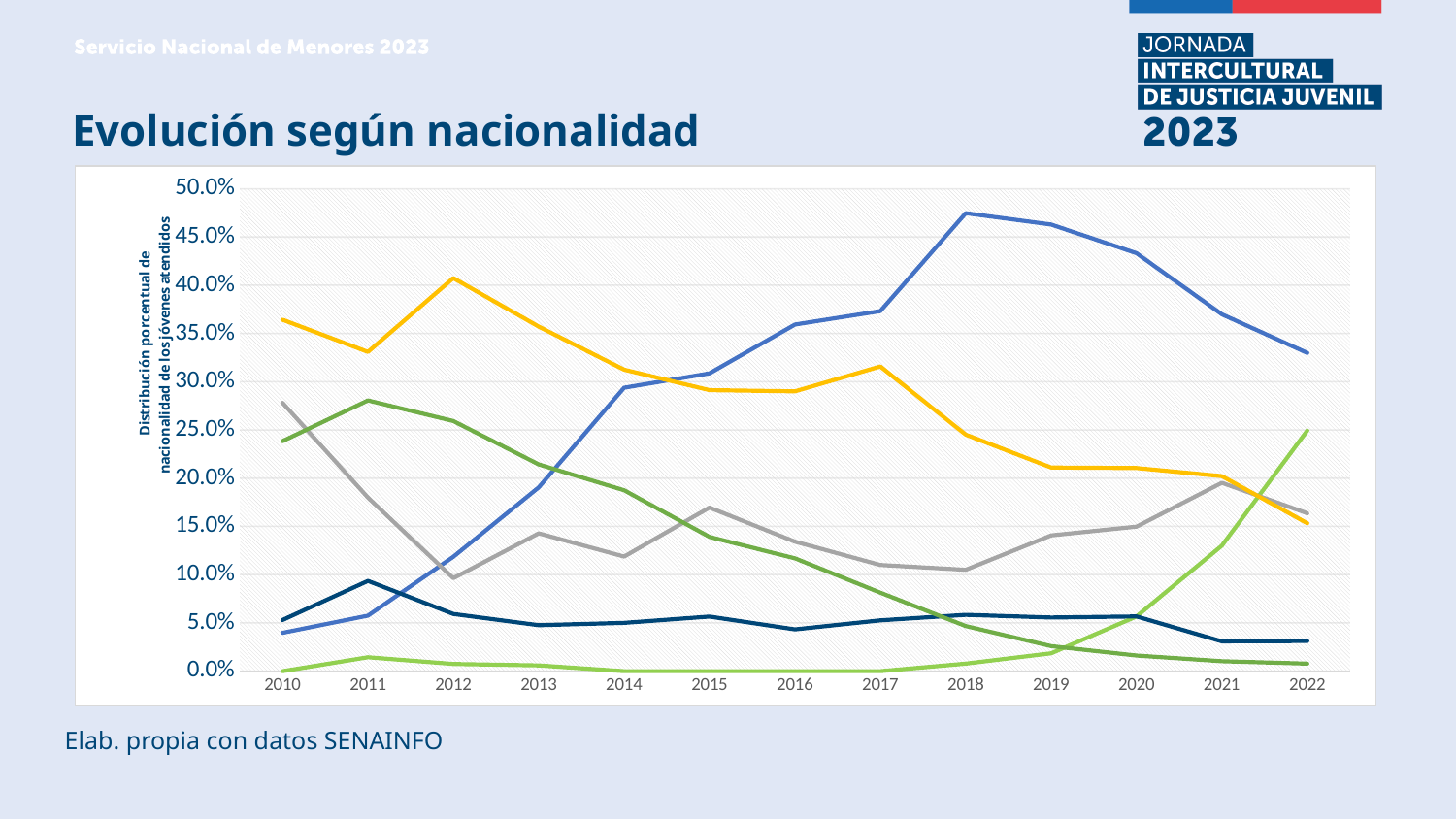
Is the value of the light green line in 2022 greater or less than 20.0%? greater In 2016, which is larger: the value of the blue line or the value of the yellow line? the blue line Which line has the lowest value in 2010? the light green line Is the value of the yellow line in 2012 greater or less than 35.0%? greater In which year does the blue line reach its highest value? 2018 Is the value of the dark blue line in 2011 greater or less than 5.0%? greater Which line has the highest value in 2022? the blue line What is the title of the chart on the slide? Evolución según nacionalidad What kind of chart is shown on the slide? line chart How many years are shown along the x axis of the chart? 13 What is the label on the vertical axis of the chart? Distribución porcentual de nacionalidad de los jóvenes atendidos